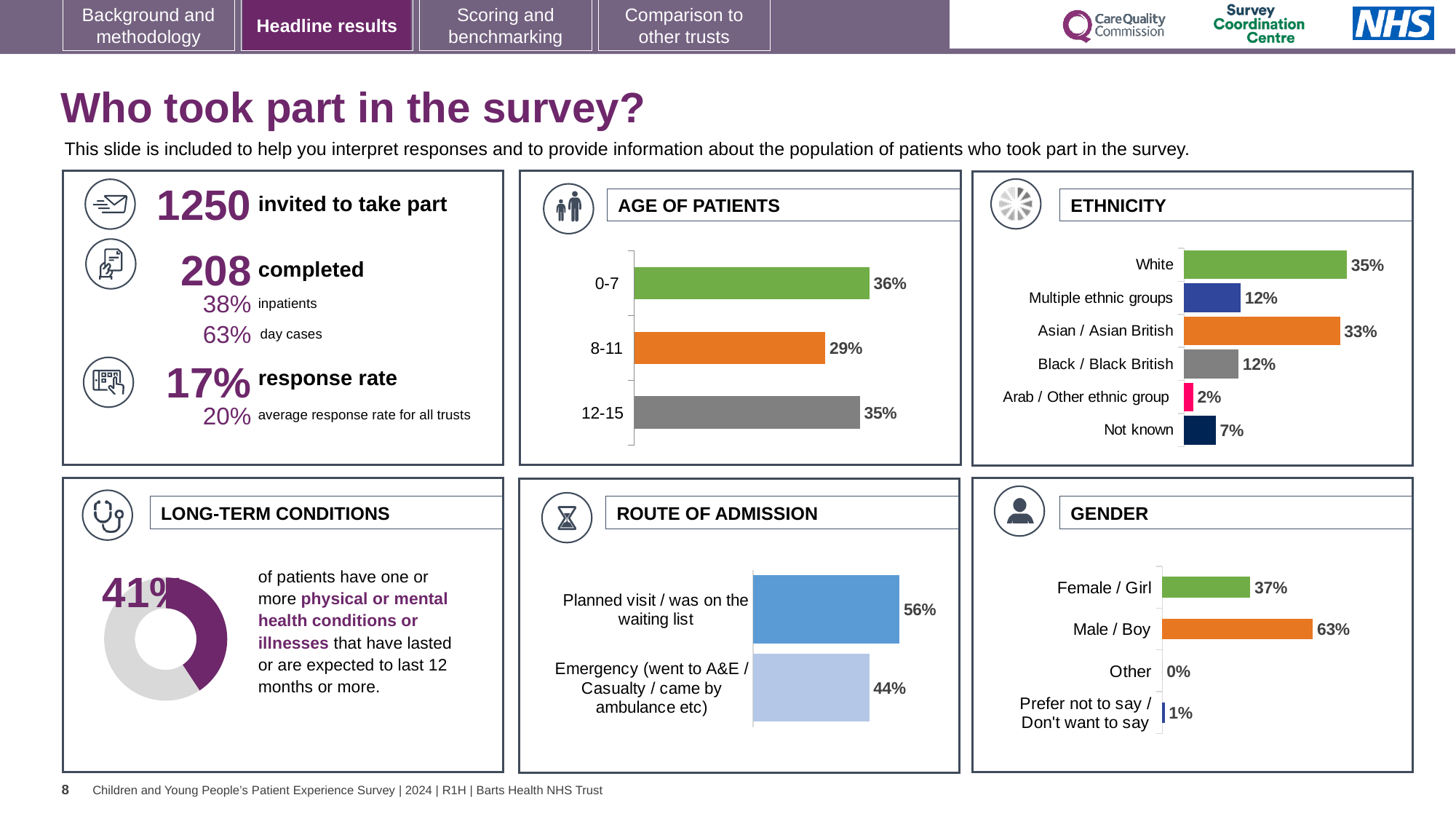
In the AGE OF PATIENTS chart, how many age groups are shown? 3 In the ROUTE OF ADMISSION chart, which route has the larger percentage: Planned visit / was on the waiting list or Emergency? Planned visit / was on the waiting list In the GENDER chart, what percentage of patients were Male / Boy? 63% In the ETHNICITY chart, what is the difference between the White and Not known percentages? 28% In the ETHNICITY chart, what percentage of patients were Asian / Asian British? 33% In the ROUTE OF ADMISSION chart, what percentage of patients came via Emergency (went to A&E / Casualty / came by ambulance etc)? 44% In the GENDER chart, what is the difference between the Male / Boy and Female / Girl percentages? 26% In the ETHNICITY chart, which category has the highest percentage? White In the ETHNICITY chart, how many ethnicity categories are listed? 6 In the AGE OF PATIENTS chart, which age group has the lowest percentage? 8-11 In the AGE OF PATIENTS chart, what percentage of patients were aged 0-7? 36% What kind of chart is used in the LONG-TERM CONDITIONS panel? Donut chart